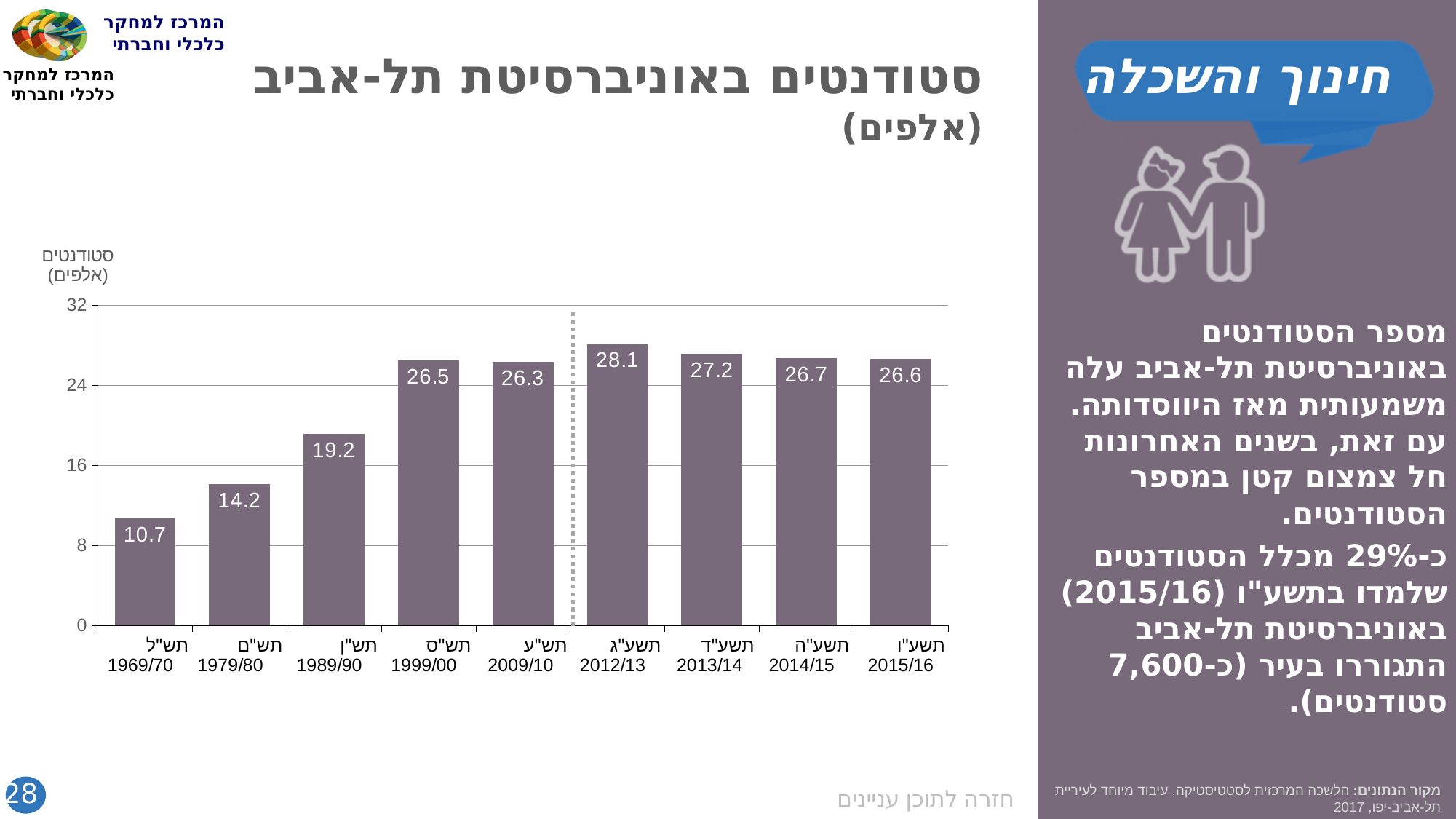
What is the value shown for 2012/13? 28.1 What is the difference between the values for 1989/90 and 1979/80? 5.0 What is the difference between the values for 2012/13 and 2015/16? 1.5 What type of chart is shown on the slide? bar chart What is the number of students (thousands) at Tel Aviv University in 1969/70? 10.7 Which is larger, the value for 1999/00 or the value for 2009/10? 1999/00 Which academic year has the lowest number of students? 1969/70 How many bars (academic years) are plotted in the chart? 9 What is the value shown for 2015/16? 26.6 What is the unit of the y axis, as stated in the axis label? סטודנטים (אלפים) Which academic year has the highest number of students? 2012/13 Is the value for 1989/90 greater or less than 16? greater